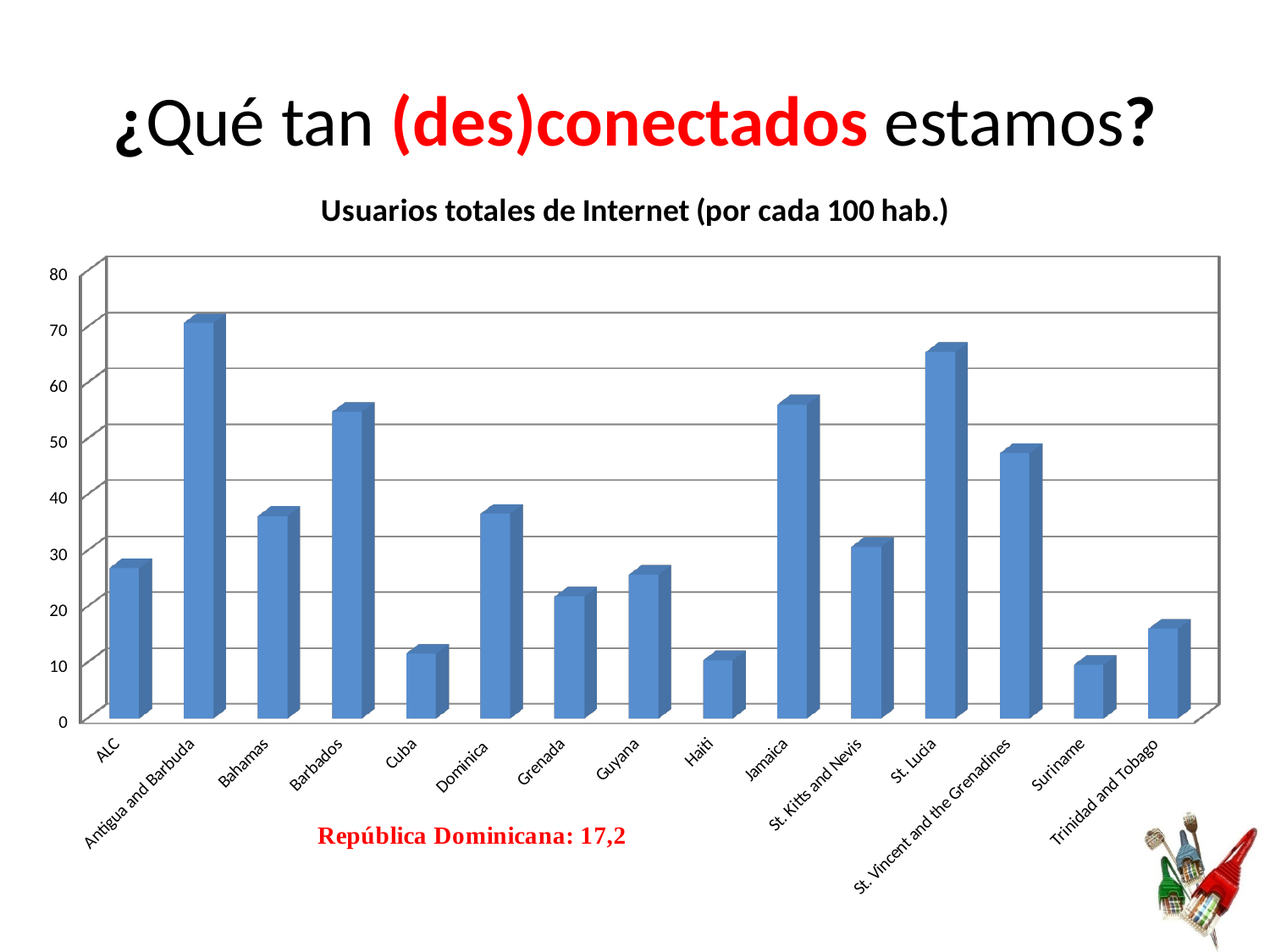
What value does the slide give for República Dominicana below the chart? 17,2 Which category has the highest value in the chart? Antigua and Barbuda What is the title of the chart? Usuarios totales de Internet (por cada 100 hab.) How many categories (bars) does the chart show? 15 Which has a larger value, Jamaica or Bahamas? Jamaica What kind of chart is shown on the slide? bar chart Is the value for St. Lucia greater or less than 60? greater Is the value for Antigua and Barbuda greater or less than 60? greater Is the value for Haiti greater or less than 20? less Which has a larger value, Barbados or Dominica? Barbados